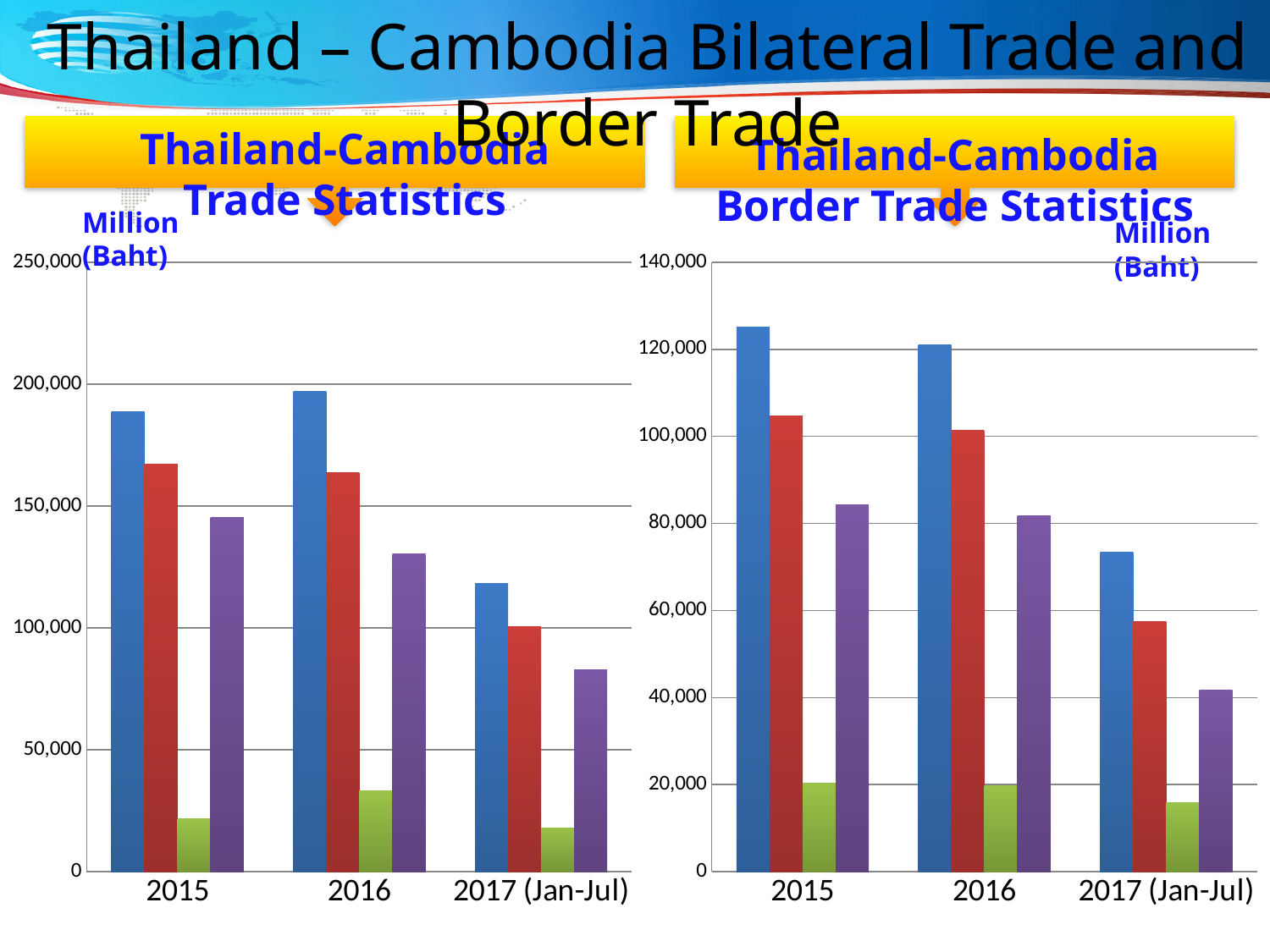
What unit is shown on the y axis of the Thailand-Cambodia Border Trade Statistics chart? Million (Baht) In the Thailand-Cambodia Trade Statistics chart, is the green bar for 2017 (Jan-Jul) greater or less than 50,000? less In the Thailand-Cambodia Trade Statistics chart, is the blue bar for 2016 greater or less than 150,000? greater What kind of chart is the Thailand-Cambodia Trade Statistics chart on the left? bar chart In the Thailand-Cambodia Border Trade Statistics chart, does the red series rise or fall from 2015 to 2017 (Jan-Jul)? fall How many year categories are shown on the x axis of the Thailand-Cambodia Border Trade Statistics chart? 3 In the Thailand-Cambodia Border Trade Statistics chart, is the blue bar for 2015 greater or less than 120,000? greater In the Thailand-Cambodia Border Trade Statistics chart, which year has the highest red bar? 2015 In the Thailand-Cambodia Trade Statistics chart, which year has the lowest blue bar? 2017 (Jan-Jul) What is the title of the chart on the right side of the slide? Thailand-Cambodia Border Trade Statistics In the Thailand-Cambodia Trade Statistics chart, which is larger for 2015: the red bar or the purple bar? the red bar